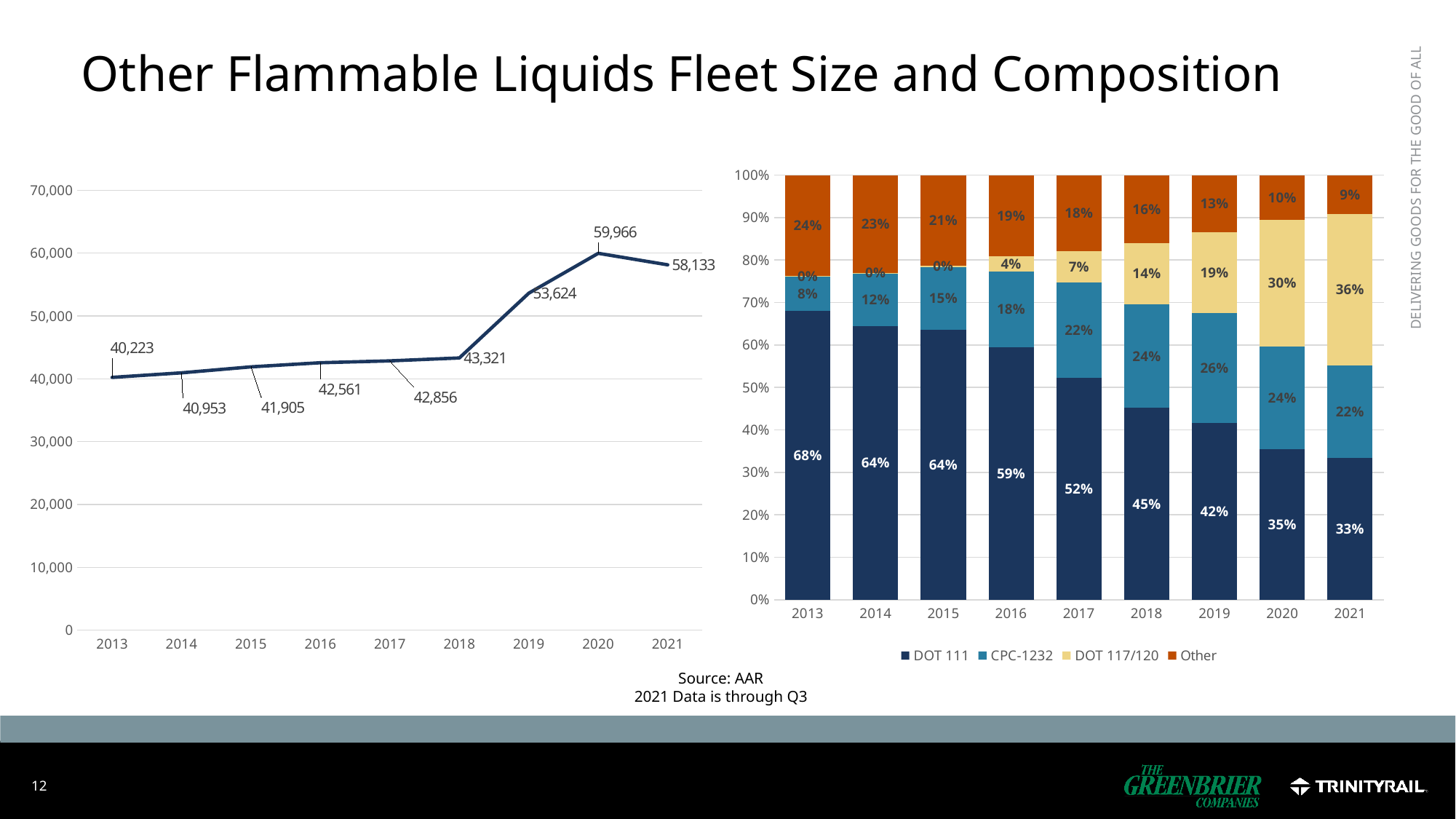
In the stacked bar chart on the right, does the DOT 111 share rise or fall from 2013 to 2021? fall In the line chart on the left, what is the value for 2013? 40,223 In the line chart on the left, which year has the highest value? 2020 In the stacked bar chart on the right, which is larger in 2020: the CPC-1232 share or the DOT 117/120 share? DOT 117/120 In the stacked bar chart on the right, how many series does the legend list? 4 In the line chart on the left, what is the value for 2020? 59,966 What kind of chart is the chart on the left? line chart In the stacked bar chart on the right, what is the DOT 117/120 share in 2019? 19% In the line chart on the left, how many years are plotted? 9 In the line chart on the left, which year has the lowest value? 2013 In the line chart on the left, what is the difference between the 2020 value and the 2021 value? 1,833 In the stacked bar chart on the right, what is the DOT 111 share in 2021? 33%